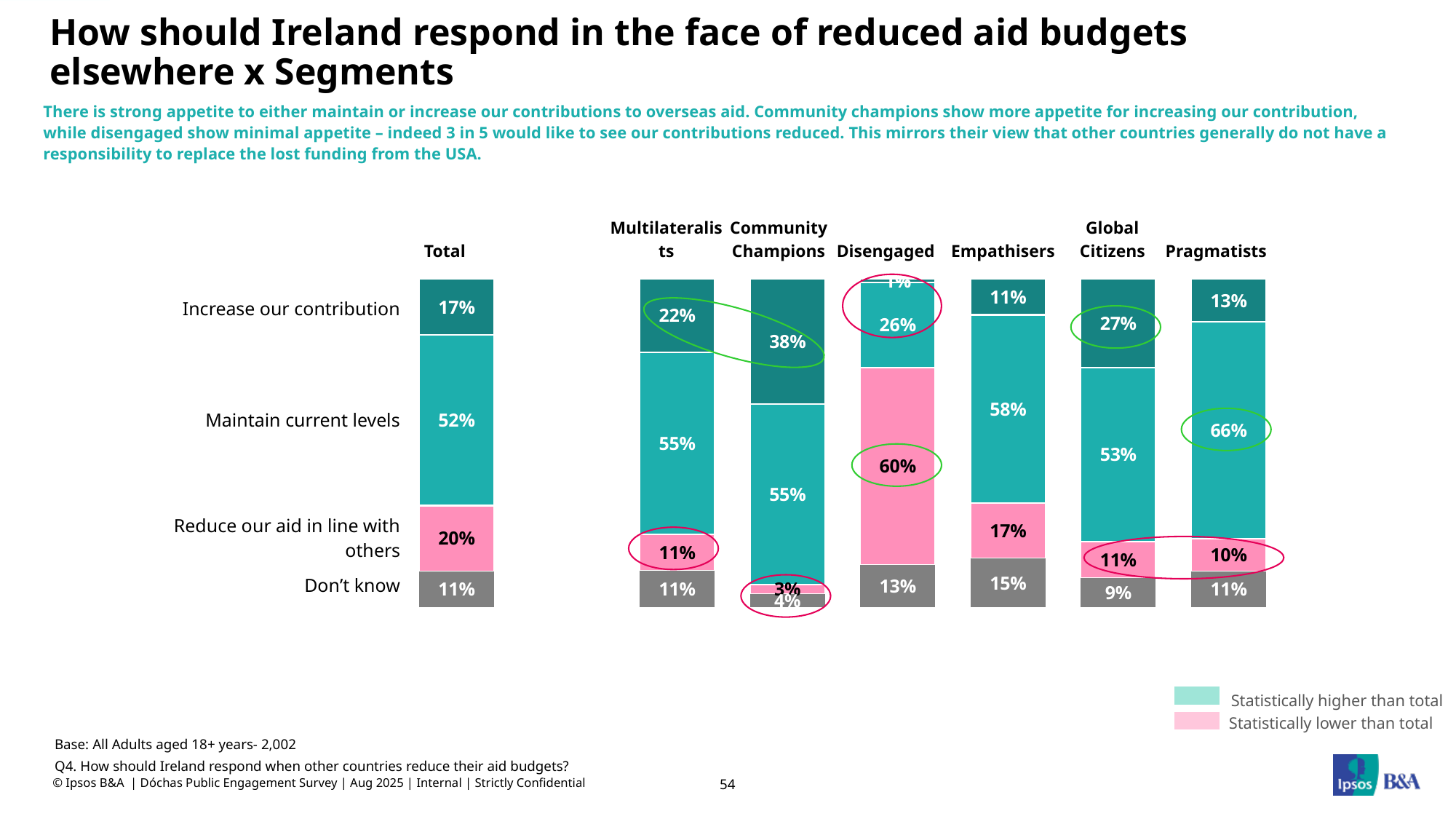
What is the difference between the Disengaged and Total shares for 'Reduce our aid in line with others'? 40 percentage points According to the legend, what does the pink shading indicate? Statistically lower than total What percentage of the Total would maintain current levels of aid contribution? 52% What percentage of Community Champions would increase our contribution? 38% Which is larger: the 'Increase our contribution' share for Global Citizens or for Empathisers? Global Citizens What type of chart is shown on the slide? Stacked bar chart What percentage of the Disengaged segment would reduce our aid in line with others? 60% How many response categories are stacked in each bar? 4 Which segment has the lowest share wanting to reduce our aid in line with others? Community Champions How many segment columns are shown in addition to the Total column? 6 What percentage of Pragmatists would maintain current levels? 66% Which segment has the highest share wanting to increase our contribution? Community Champions